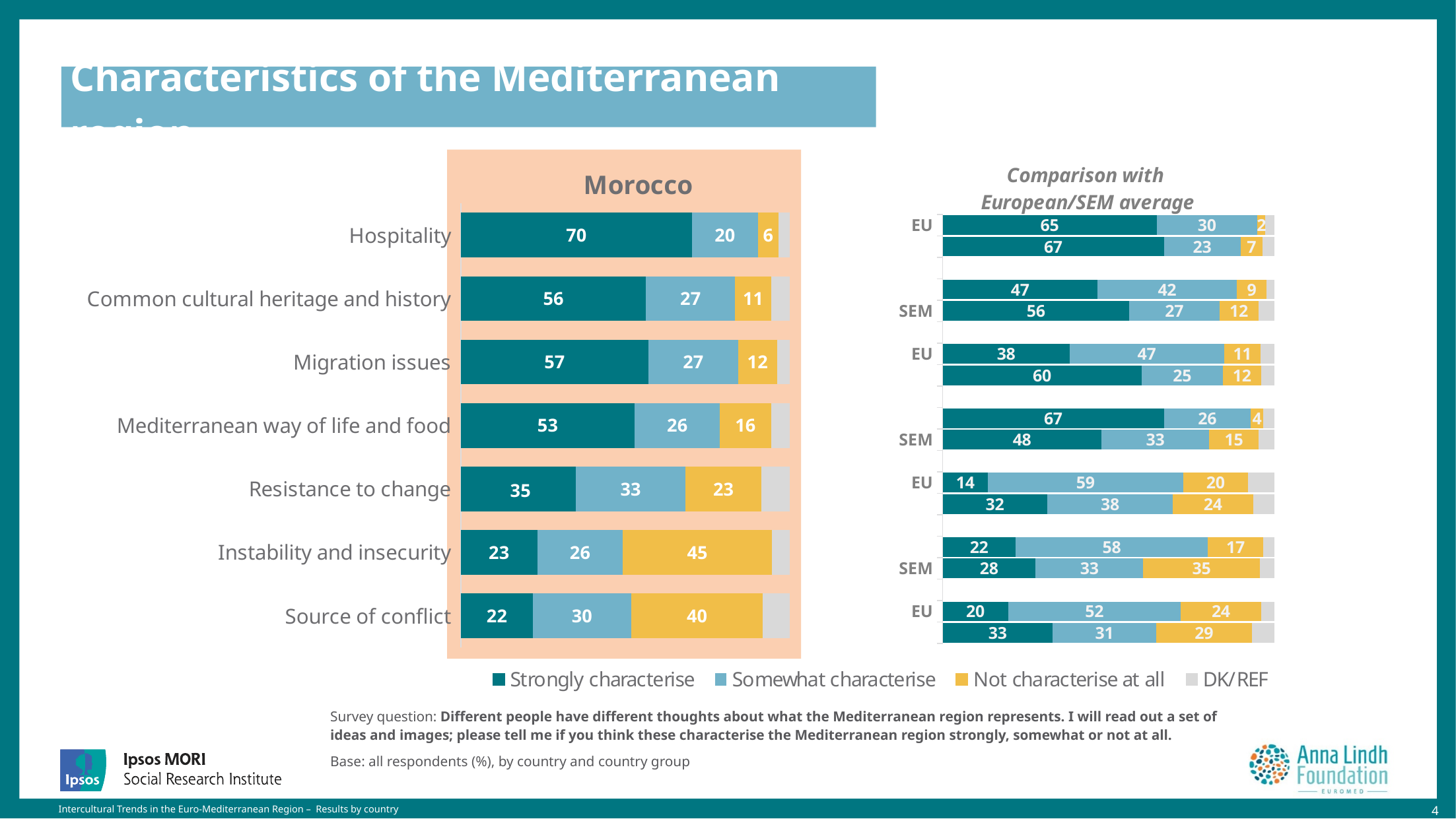
What type of chart is the Morocco chart? Bar chart In the Morocco chart, what is the difference between the 'Strongly characterise' values for Hospitality and Source of conflict? 48 In the Comparison with European/SEM average chart, what is the difference between the SEM and EU 'Strongly characterise' values in the Resistance to change row? 18 In the Morocco chart, for Resistance to change, which is larger: 'Somewhat characterise' or 'Not characterise at all'? Somewhat characterise In the Comparison with European/SEM average chart, what is the 'Strongly characterise' value for the EU bar in the top (Hospitality) row? 65 How many categories are shown in the Morocco chart? 7 In the Morocco chart, what is the 'Not characterise at all' value for Instability and insecurity? 45 In the Morocco chart, which category has the highest 'Strongly characterise' value? Hospitality In the Comparison with European/SEM average chart, what is the 'Not characterise at all' value for the SEM bar in the bottom (Source of conflict) row? 29 In the Morocco chart, which category has the lowest 'Strongly characterise' value? Source of conflict In the Morocco chart, what percentage say Hospitality strongly characterises the Mediterranean region? 70 How many series does the legend list? 4